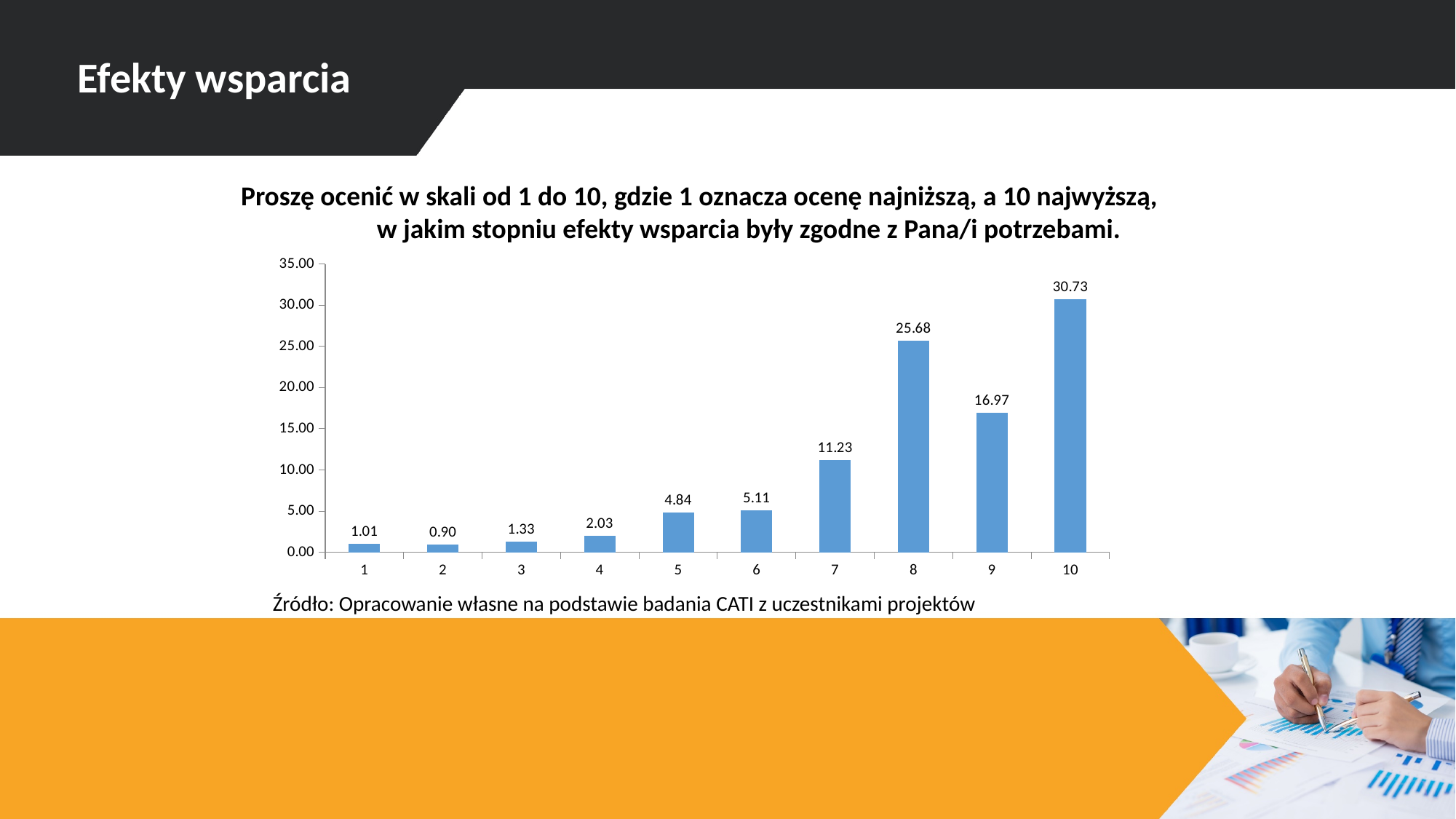
What is the value for rating 10? 30.73 Which rating has the highest value? 10 Which has a larger value, rating 5 or rating 6? 6 What is the maximum value shown on the y axis? 35.00 What kind of chart is shown on the slide? bar chart Which rating has the lowest value? 2 What is the difference between the values for rating 8 and rating 9? 8.71 What is the value for rating 7? 11.23 How many rating categories are shown on the x axis? 10 What is the value for rating 2? 0.90 Do the values generally rise or fall from rating 4 to rating 8? rise Is the value for rating 8 greater or less than 25.00? greater